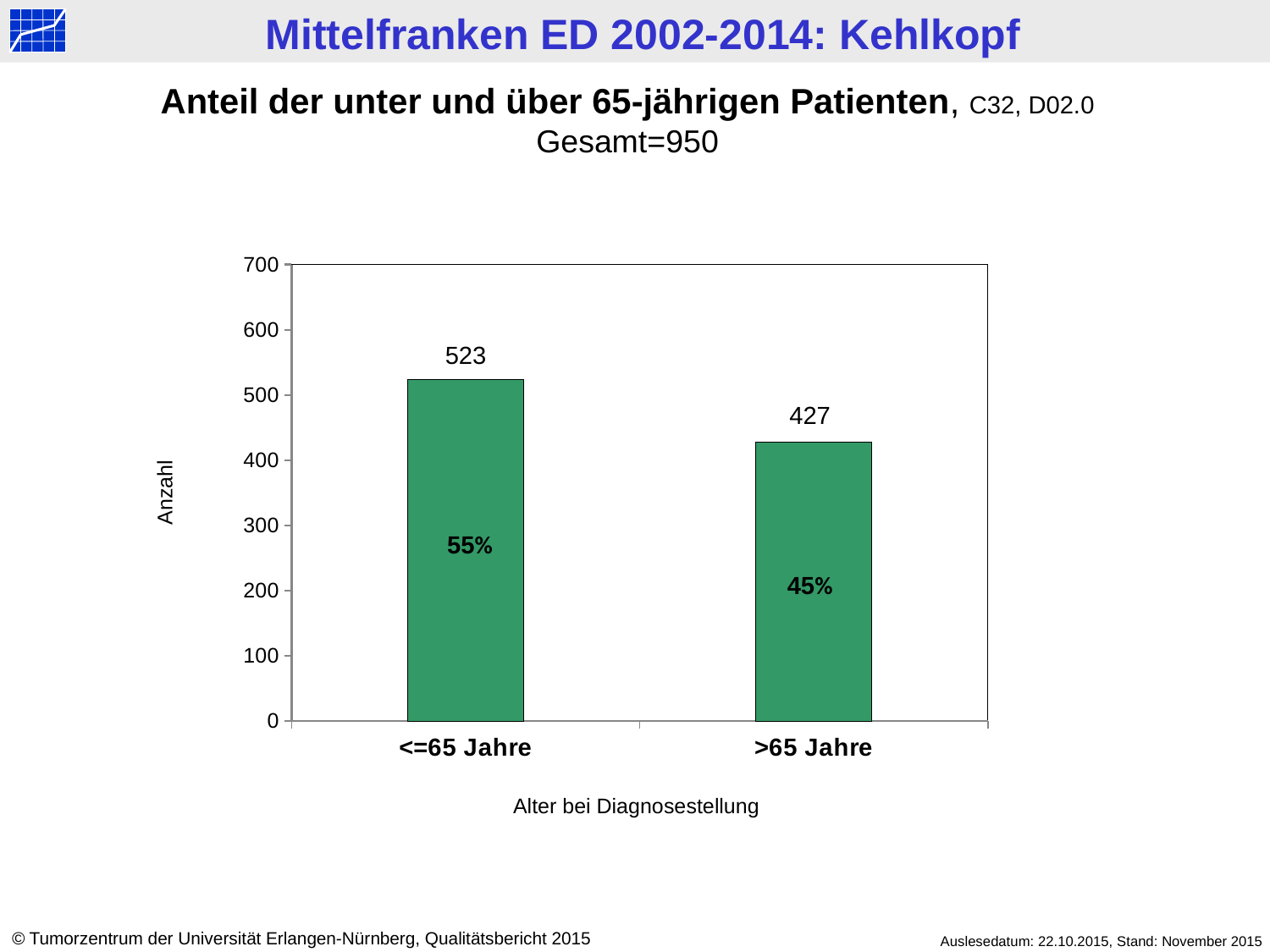
What percentage share is printed on the bar for >65 Jahre? 45% What is the label of the x axis? Alter bei Diagnosestellung Which category has the highest value? <=65 Jahre Which is larger, the value for <=65 Jahre or the value for >65 Jahre? <=65 Jahre What percentage share is printed on the bar for <=65 Jahre? 55% What is the difference between the values for <=65 Jahre and >65 Jahre? 96 What is the value for the >65 Jahre category? 427 What is the value for the <=65 Jahre category? 523 Which category has the lowest value? >65 Jahre Is the value for >65 Jahre greater or less than 500? less How many categories are shown on the x axis? 2 What kind of chart is shown on the slide? bar chart